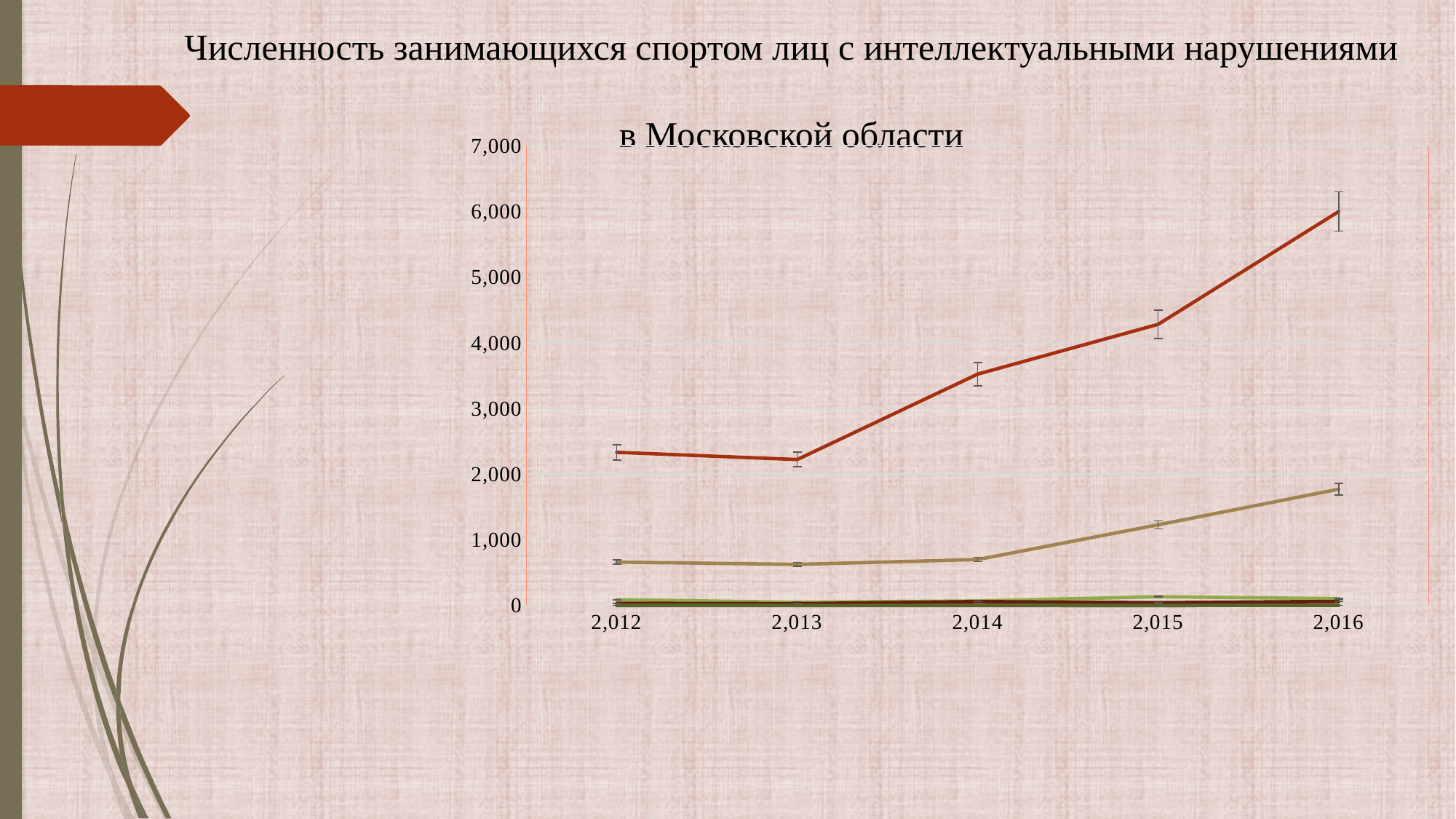
Does the red line rise or fall between 2,013 and 2,016? rise How many years are shown along the x axis of the chart? 5 What is the highest value shown on the y axis of the chart? 7,000 What is the title of the chart on the slide? Численность занимающихся спортом лиц с интеллектуальными нарушениями в Московской области In which year does the tan line reach its highest value? 2,016 Is the value of the tan line in 2,012 greater or less than 1,000? less In which year does the red line reach its highest value? 2,016 Is the value of the red line in 2,012 greater or less than 2,000? greater In 2,016, which line has the larger value, the red line or the tan line? the red line Is the value of the red line in 2,016 greater or less than 5,000? greater What kind of chart is shown on the slide? line chart